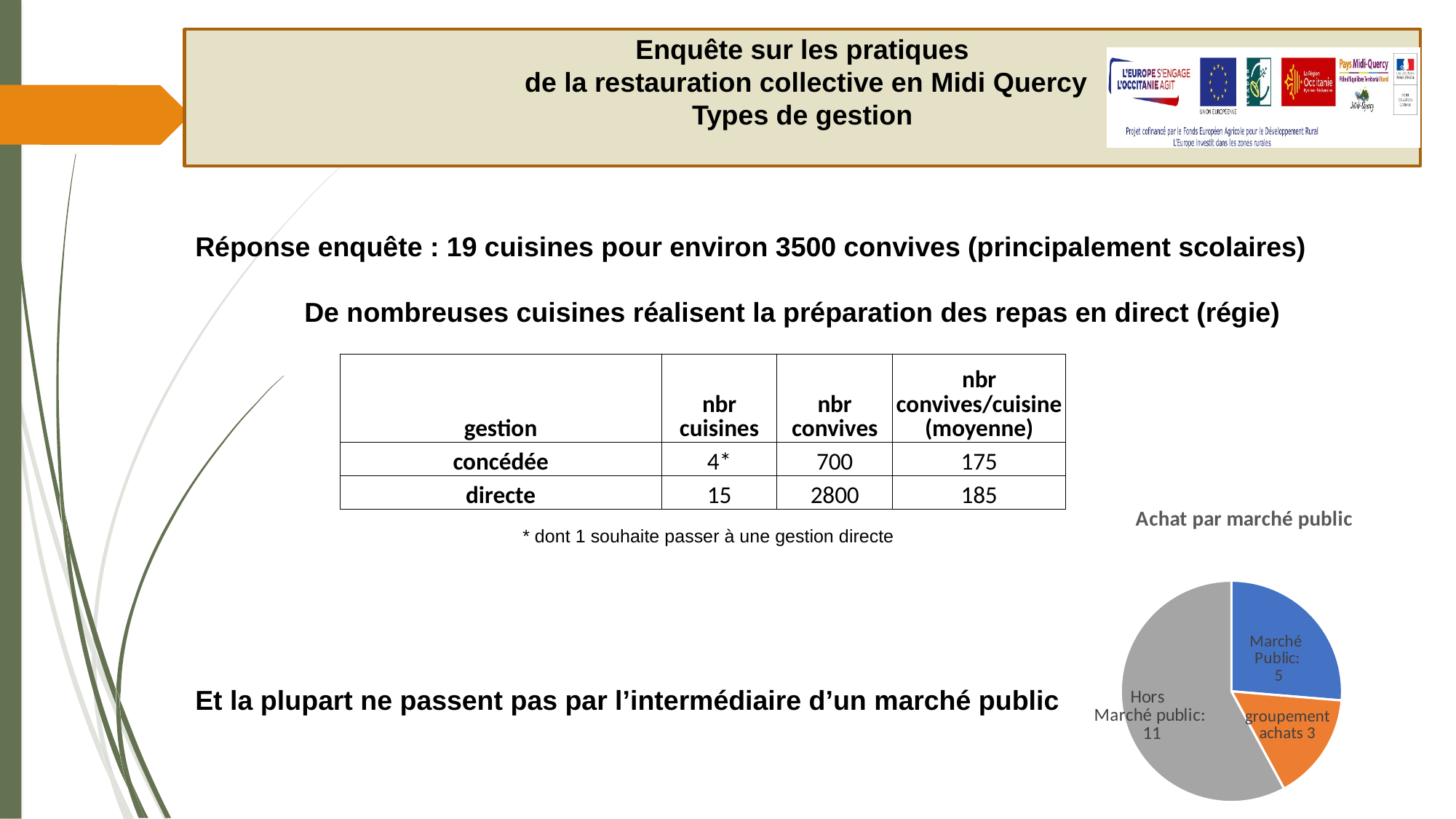
Which slice of the "Achat par marché public" pie chart is the smallest? groupement achats Which slice of the "Achat par marché public" pie chart is the largest? Hors Marché public In the "Achat par marché public" pie chart, what is the value for "Hors Marché public"? 11 In the "Achat par marché public" pie chart, which is larger: "Marché Public" or "groupement achats"? Marché Public In the "Achat par marché public" pie chart, what is the difference between "Hors Marché public" and "Marché Public"? 6 What is the title of the pie chart on the slide? Achat par marché public In the "Achat par marché public" pie chart, what is the value for "groupement achats"? 3 In the "Achat par marché public" pie chart, what is the total of all slices? 19 What kind of chart is shown under the title "Achat par marché public"? pie chart In the "Achat par marché public" pie chart, what is the value for "Marché Public"? 5 In the "Achat par marché public" pie chart, what colour is the "Hors Marché public" slice? grey How many slices does the "Achat par marché public" pie chart have? 3